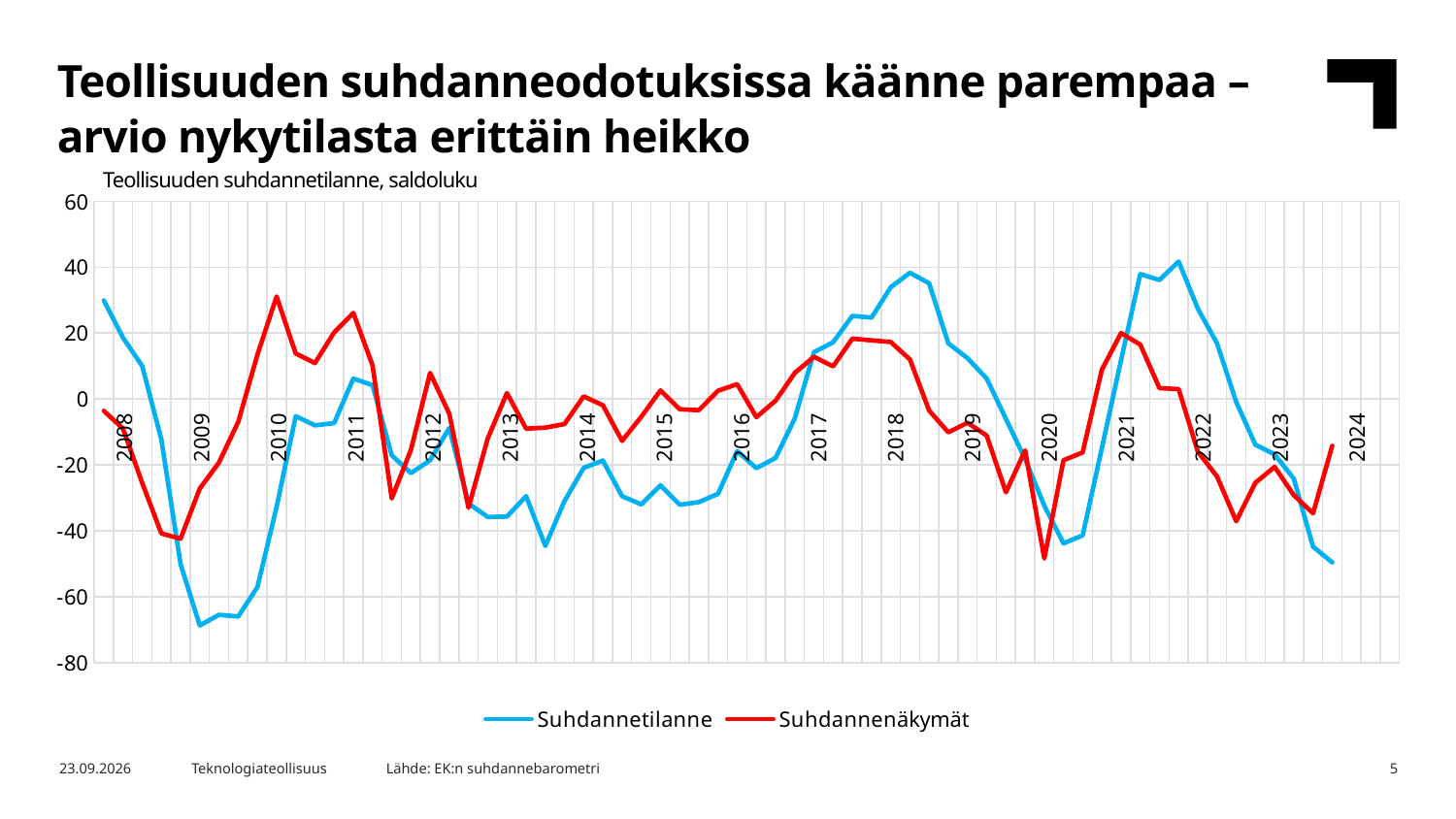
What is the subtitle printed above the chart? Teollisuuden suhdannetilanne, saldoluku What kind of chart is shown on the slide? line chart Is the lowest value of the Suhdannenäkymät line around 2020 greater or less than -40? less Which series reaches the lowest value anywhere on the chart? Suhdannetilanne Does the Suhdannetilanne line rise or fall from 2021 to 2023? fall Is the peak of the Suhdannetilanne line around 2018 greater or less than 20? greater Is the lowest value of the Suhdannetilanne line around 2009 greater or less than -60? less How many series does the legend list? 2 Which series reaches the highest value anywhere on the chart? Suhdannetilanne How many year labels are shown on the x axis? 17 Around 2009, which series has the lower value, Suhdannetilanne or Suhdannenäkymät? Suhdannetilanne What are the two series named in the legend? Suhdannetilanne and Suhdannenäkymät